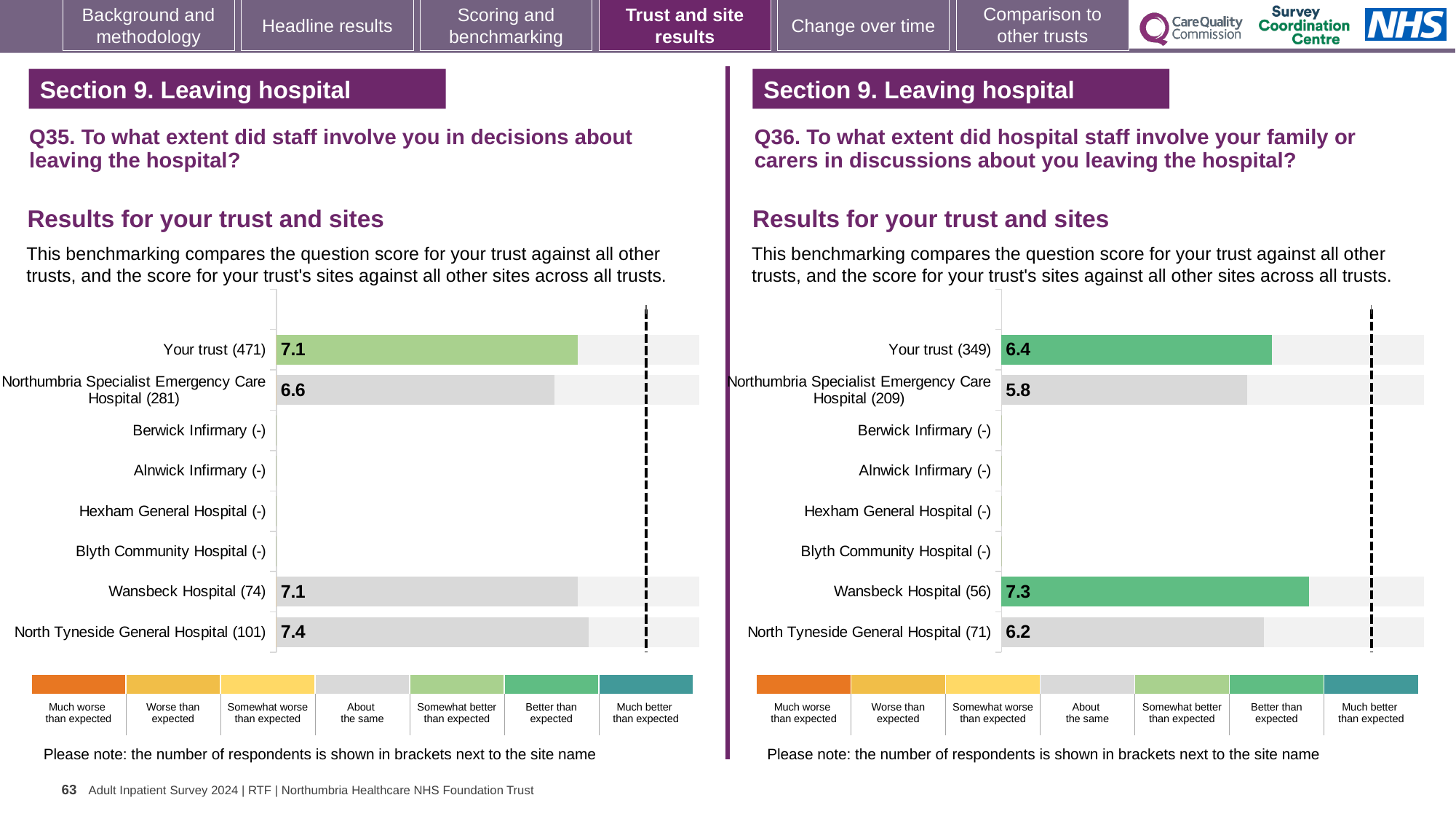
On the Q36 chart (right), how many respondents are shown in brackets for Your trust? 349 On the Q35 chart (left), what is the score for Your trust? 7.1 On the Q36 chart (right), what is the difference between the scores for Wansbeck Hospital and Your trust? 0.9 On the Q36 chart (right), which is larger: the score for North Tyneside General Hospital or Northumbria Specialist Emergency Care Hospital? North Tyneside General Hospital How many site/trust categories are listed on the Q35 chart (left)? 8 What kind of chart is the Q36 chart (right)? Bar chart On the Q36 chart (right), what is the score for Wansbeck Hospital? 7.3 On the Q35 chart (left), what is the difference between the scores for North Tyneside General Hospital and Northumbria Specialist Emergency Care Hospital? 0.8 On the Q36 chart (right), what is the score for Your trust? 6.4 On the Q35 chart (left), which site has the lowest score? Northumbria Specialist Emergency Care Hospital On the Q35 chart (left), what is the score for North Tyneside General Hospital? 7.4 On the Q36 chart (right), which site has the highest score? Wansbeck Hospital